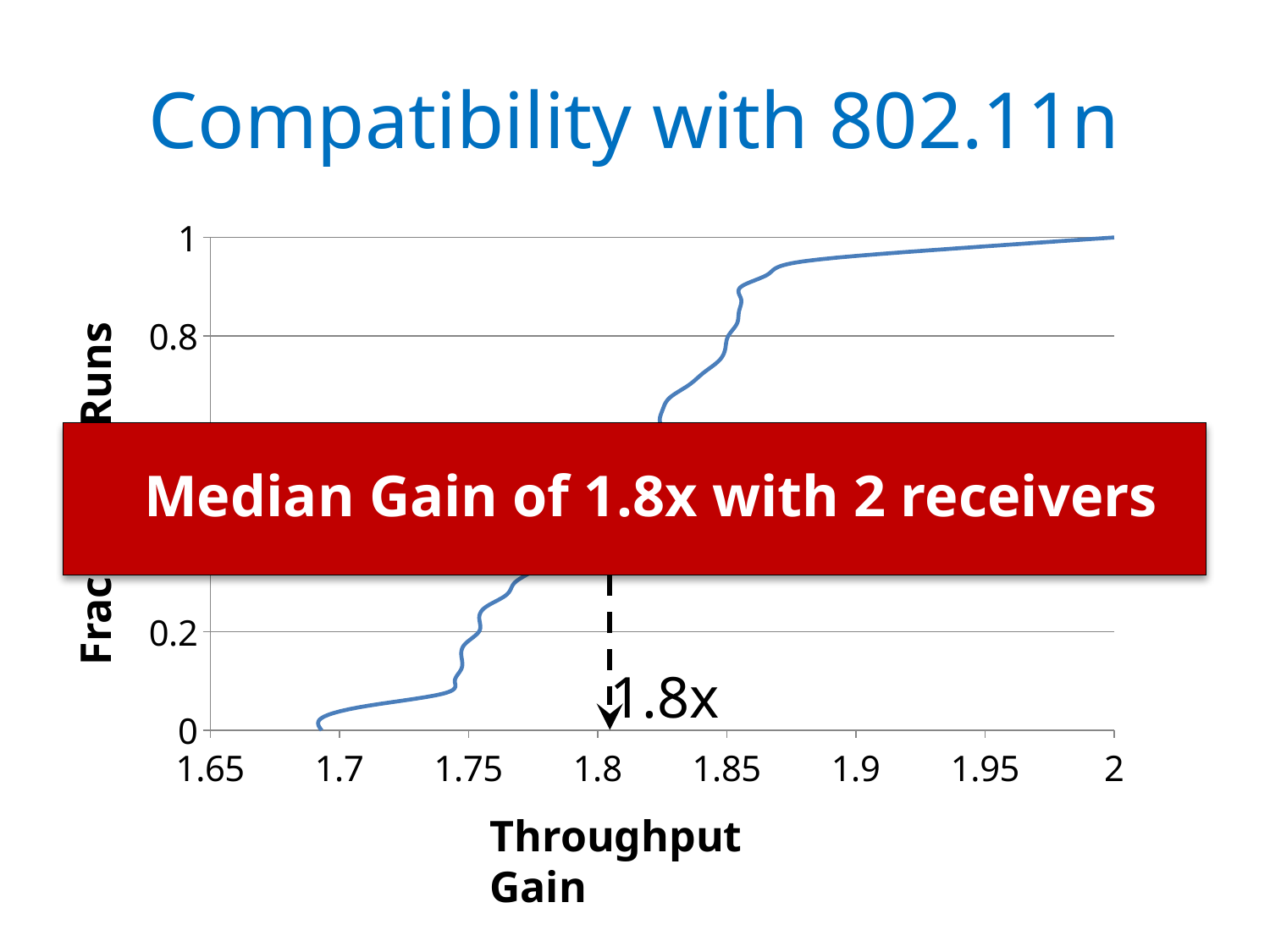
According to the banner on the chart, what is the median gain with 2 receivers? 1.8x What throughput gain value is marked by the dashed arrow annotation on the chart? 1.8x Does the plotted line rise or fall as throughput gain increases along the x axis? rise What is the title of the slide containing the chart? Compatibility with 802.11n What kind of chart is shown on the slide? line chart Is the fraction of runs at a throughput gain of 1.7 greater or less than 0.2? less What is the highest value shown on the x axis? 2 What is the label of the x axis? Throughput Gain Is the fraction of runs at a throughput gain of 1.85 greater or less than 0.2? greater Is the fraction of runs at a throughput gain of 1.9 greater or less than 0.8? greater What fraction of runs does the curve reach at a throughput gain of 2? 1 How many lines are plotted on the chart? 1